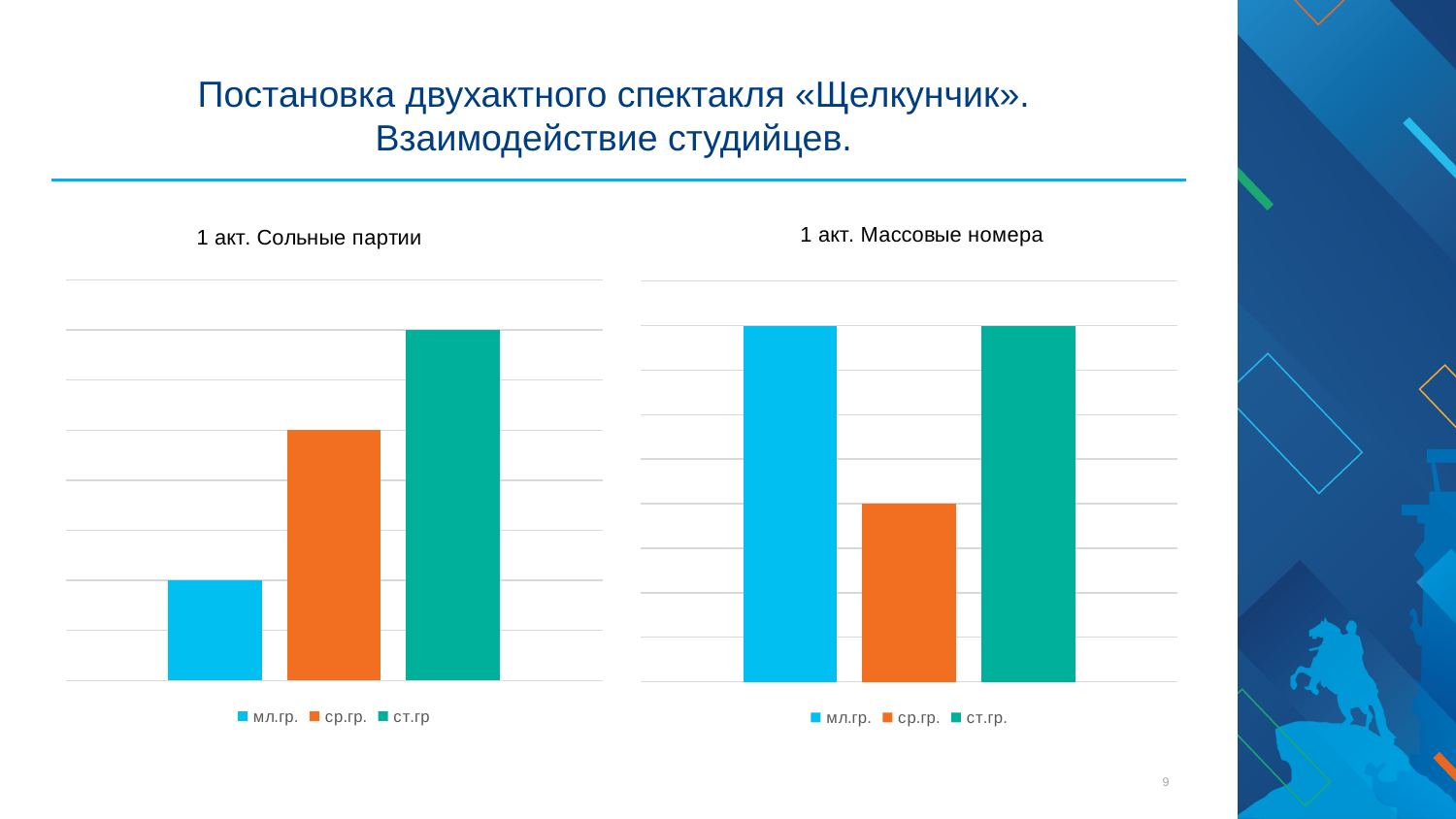
In the chart titled "1 акт. Массовые номера", which group has the lowest bar? ср.гр. In the chart titled "1 акт. Сольные партии", which group has the highest bar? ст.гр In the chart titled "1 акт. Сольные партии", do the bars rise or fall from left to right? rise In the chart titled "1 акт. Массовые номера", which is larger: the bar for ср.гр. or the bar for ст.гр.? ст.гр. How many bars are shown in the chart titled "1 акт. Сольные партии"? 3 In the chart titled "1 акт. Сольные партии", what colour is the bar for ср.гр.? orange What kind of chart is the chart titled "1 акт. Сольные партии"? bar chart How many series does the legend list in the chart titled "1 акт. Массовые номера"? 3 What kind of chart is the chart titled "1 акт. Массовые номера"? bar chart In the chart titled "1 акт. Сольные партии", which group has the lowest bar? мл.гр. In the chart titled "1 акт. Сольные партии", which is larger: the bar for мл.гр. or the bar for ср.гр.? ср.гр. What is the title of the chart on the right side of the slide? 1 акт. Массовые номера